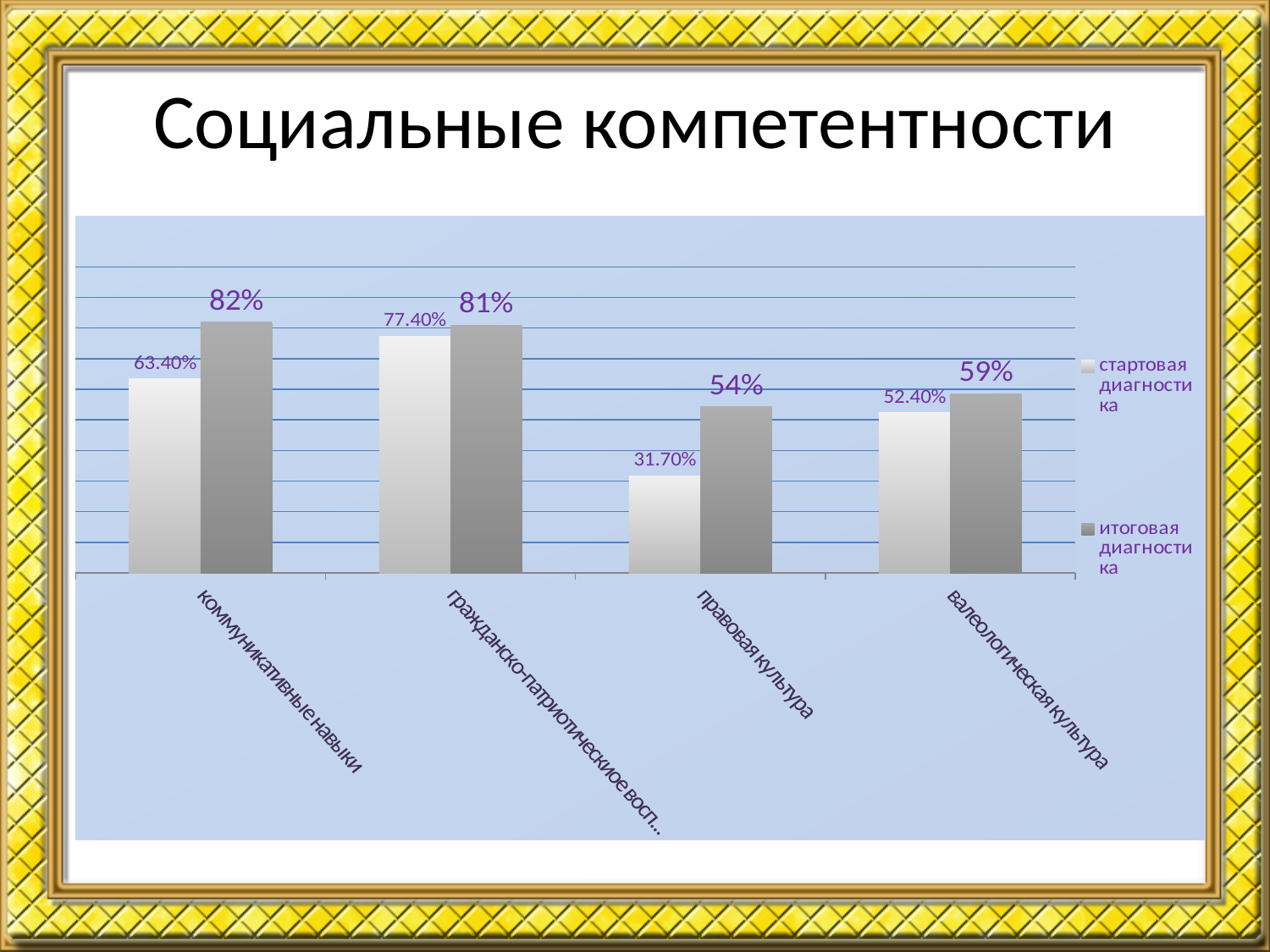
What is the difference between итоговая диагностика and стартовая диагностика for коммуникативные навыки? 18.60% What type of chart is shown on the slide? bar chart Which category has the highest итоговая диагностика value? коммуникативные навыки Which category has the lowest стартовая диагностика value? правовая культура How many series does the legend list? 2 Which is larger: стартовая диагностика for гражданско-патриотическое воспитание or итоговая диагностика for валеологическая культура? стартовая диагностика for гражданско-патриотическое воспитание What is the value of итоговая диагностика for правовая культура? 54% What is the value of стартовая диагностика for валеологическая культура? 52.40% What is the value of итоговая диагностика for гражданско-патриотическое воспитание? 81% How many categories are shown on the x axis? 4 What is the difference between итоговая диагностика and стартовая диагностика for правовая культура? 22.30% What is the value of стартовая диагностика for коммуникативные навыки? 63.40%